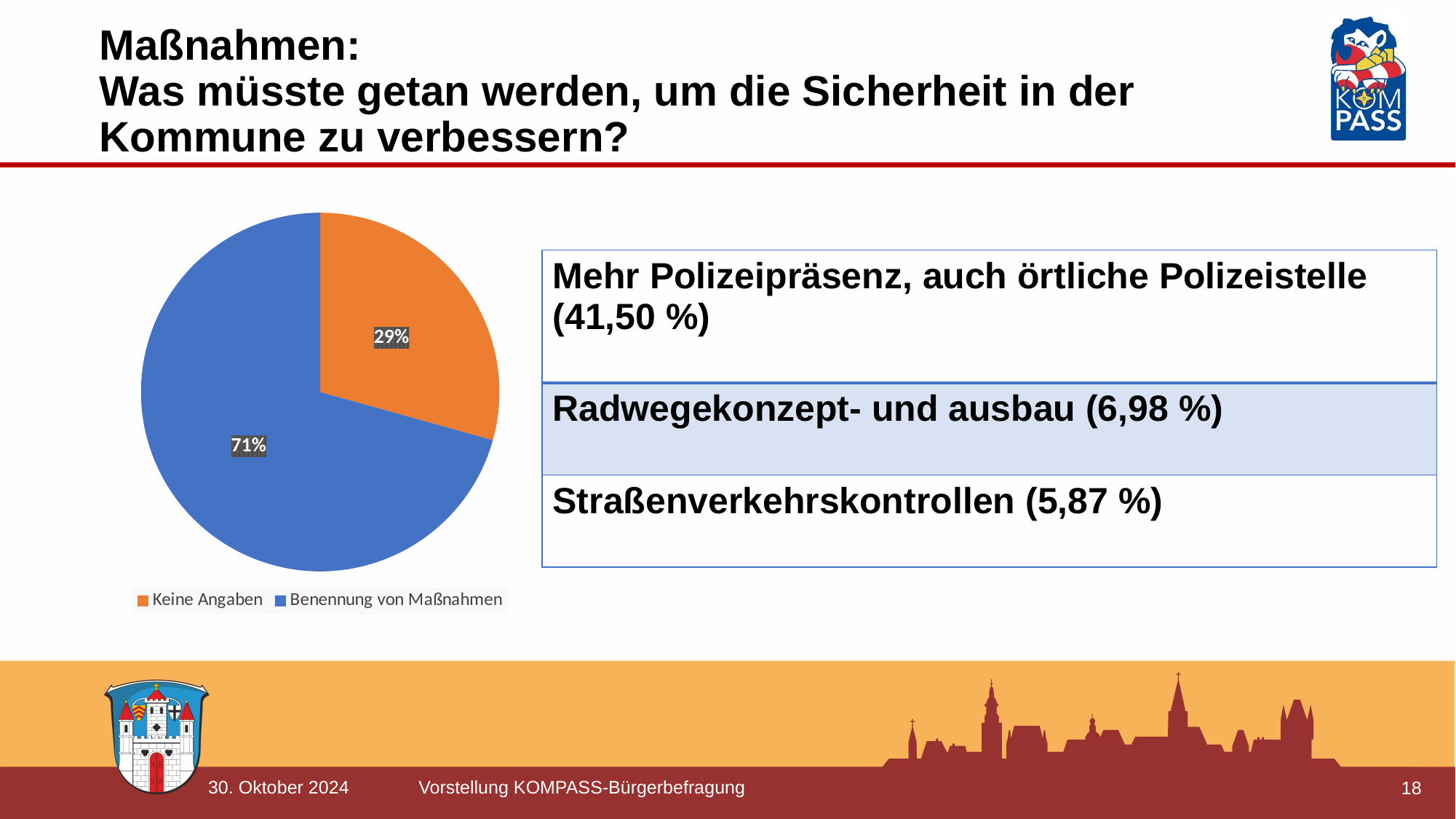
Which slice of the pie is the largest? Benennung von Maßnahmen What share of the pie is labelled "Keine Angaben"? 29% How many entries does the legend of the pie chart list? 2 Which is larger: the "Keine Angaben" slice or the "Benennung von Maßnahmen" slice? Benennung von Maßnahmen How many slices does the pie chart have? 2 Which slice of the pie is the smallest? Keine Angaben What is the difference in percentage points between the "Benennung von Maßnahmen" slice and the "Keine Angaben" slice? 42 percentage points What colour is the "Keine Angaben" slice in the pie chart? orange What kind of chart is shown on the slide? pie chart What share of the pie is labelled "Benennung von Maßnahmen"? 71% What colour is the "Benennung von Maßnahmen" slice in the pie chart? blue